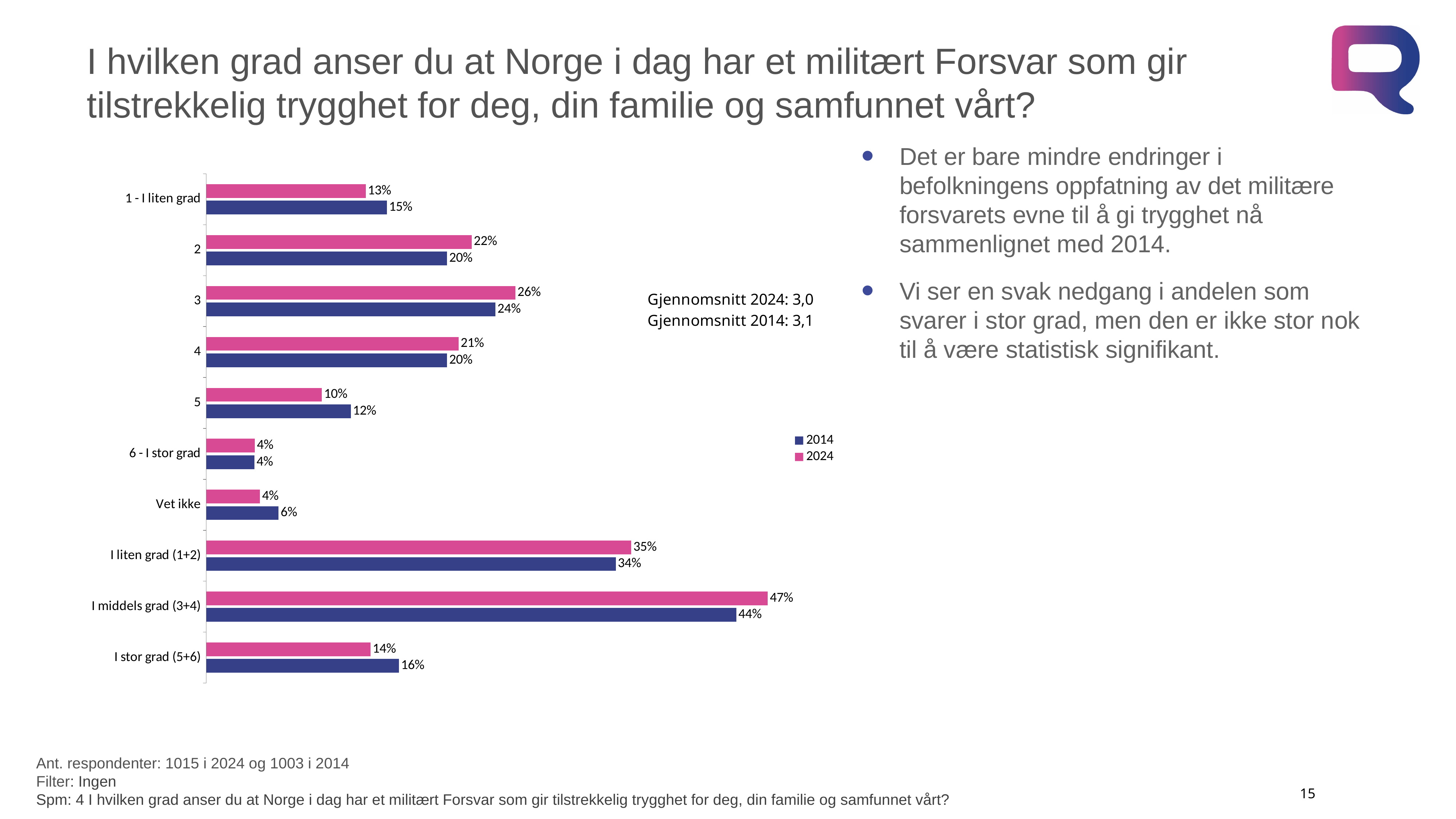
How many categories are shown on the chart? 10 How many series does the legend list? 2 What is the 2014 value for 'I stor grad (5+6)'? 16% Which category has the lowest 2014 value? 6 - I stor grad What is the 2024 value for category 3? 26% What is the 2014 value for 'Vet ikke'? 6% Which category has the highest 2024 value? I middels grad (3+4) What kind of chart is shown on the slide? Bar chart What is the difference between the 2024 and 2014 values for 'I middels grad (3+4)'? 3% What is the 2024 value for 'I middels grad (3+4)'? 47% Which is larger for category 5: the 2014 value or the 2024 value? 2014 Which colour represents the 2024 series in the chart? Pink